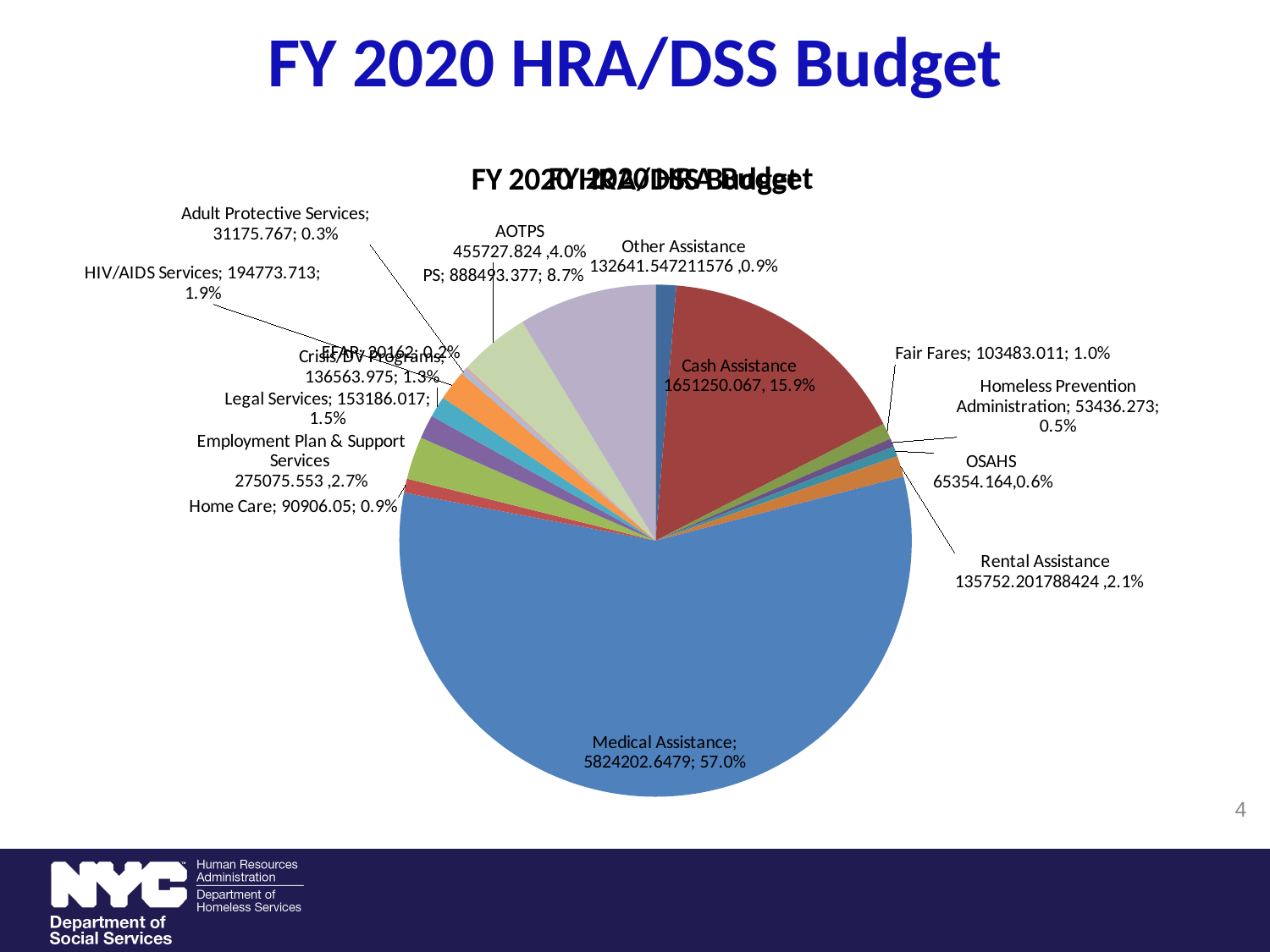
Which category has the largest slice of the pie? Medical Assistance What percentage of the budget is Adult Protective Services? 0.3% Which is larger, the value for HIV/AIDS Services or the value for Legal Services? HIV/AIDS Services What percentage of the budget is Employment Plan & Support Services? 2.7% What percentage of the budget is PS? 8.7% What is the value shown for Homeless Prevention Administration? 53436.273 What is the value shown for Cash Assistance? 1651250.067 What is the value shown for Fair Fares? 103483.011 What kind of chart is shown on the slide? pie chart What is the difference between the percentage shares of Cash Assistance and AOTPS? 11.9%